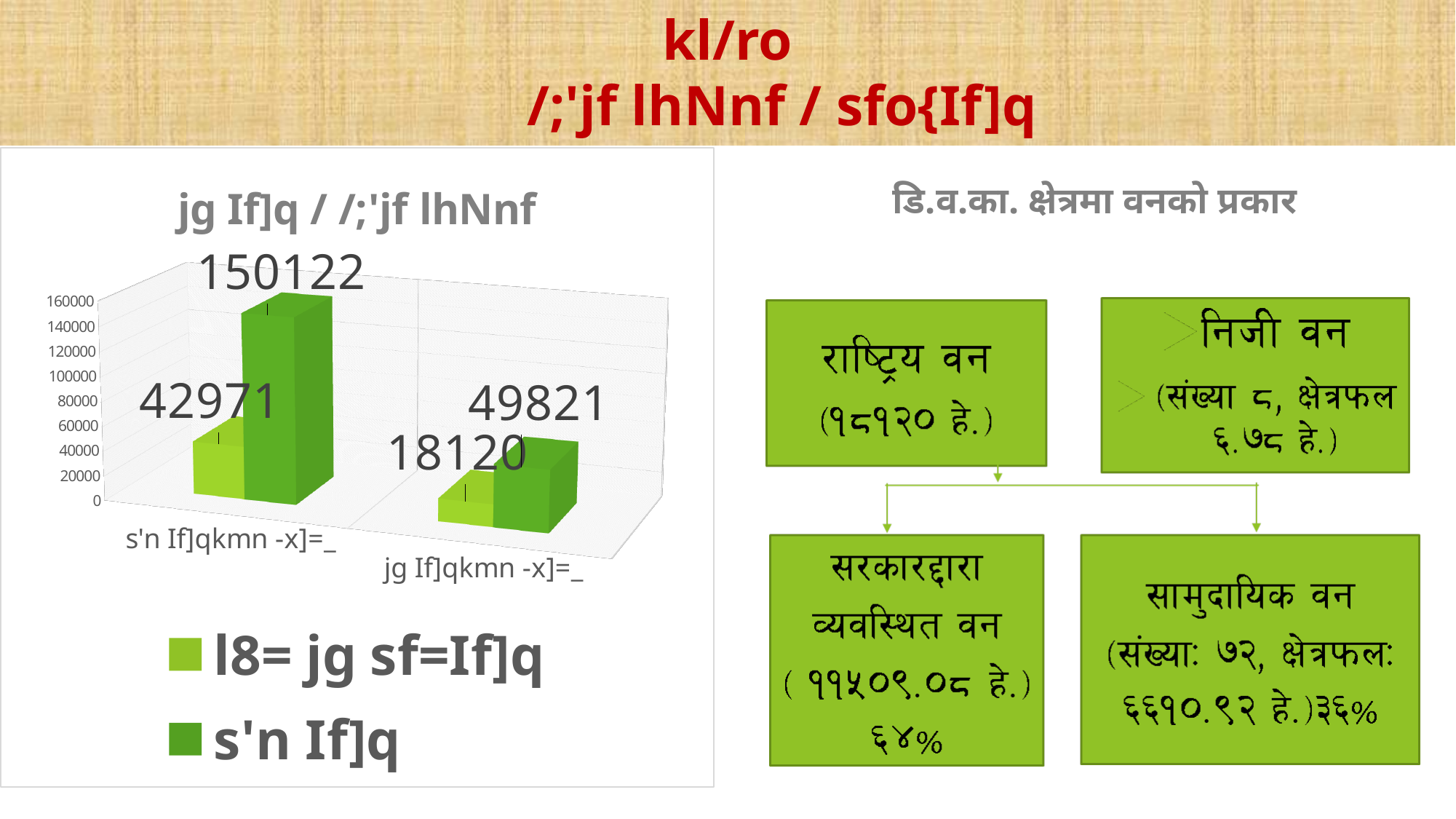
What is the difference between the two "s'n If]q" values, 150122 and 49821? 100301 Which bar in the chart has the highest value? s'n If]q for s'n If]qkmn -x]=_ How many categories are shown on the x axis of the chart? 2 What is the value of the "s'n If]q" series for the category "jg If]qkmn -x]=_"? 49821 What is the value of the "s'n If]q" series for the category "s'n If]qkmn -x]=_"? 150122 Which is larger: the "l8= jg sf=If]q" value for "s'n If]qkmn -x]=_" or for "jg If]qkmn -x]=_"? s'n If]qkmn -x]=_ What is the title of the chart on the left of the slide? jg If]q / /;'jf lhNnf How many series does the legend of the chart list? 2 What is the value of the "l8= jg sf=If]q" series for the category "s'n If]qkmn -x]=_"? 42971 Which bar in the chart has the lowest value? l8= jg sf=If]q for jg If]qkmn -x]=_ What kind of chart is shown on the left of the slide? bar chart What is the value of the "l8= jg sf=If]q" series for the category "jg If]qkmn -x]=_"? 18120